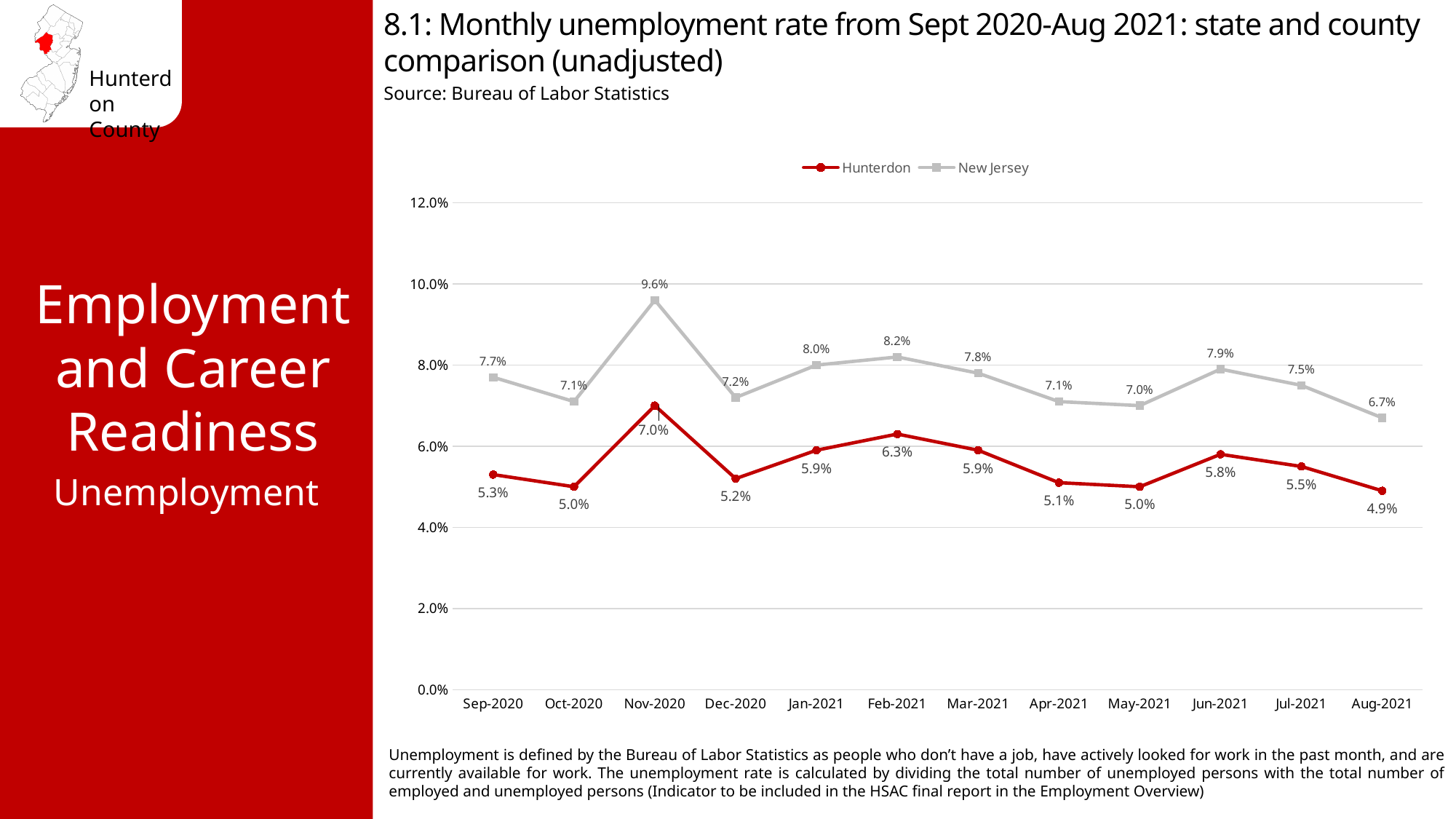
In which month did Hunterdon have its lowest unemployment rate? Aug-2021 How many months are plotted on the x axis? 12 How many series does the legend list? 2 Is the New Jersey unemployment rate in Nov-2020 greater or less than 8.0%? greater What was the Hunterdon unemployment rate in Nov-2020? 7.0% What was the Hunterdon unemployment rate in Aug-2021? 4.9% What kind of chart is shown on the slide? Line chart Which had the higher unemployment rate in Jan-2021, Hunterdon or New Jersey? New Jersey What is the difference between the New Jersey and Hunterdon unemployment rates in Nov-2020? 2.6% Did the Hunterdon unemployment rate rise or fall from Jun-2021 to Aug-2021? Fall What was the New Jersey unemployment rate in Feb-2021? 8.2% In which month did New Jersey have its highest unemployment rate? Nov-2020